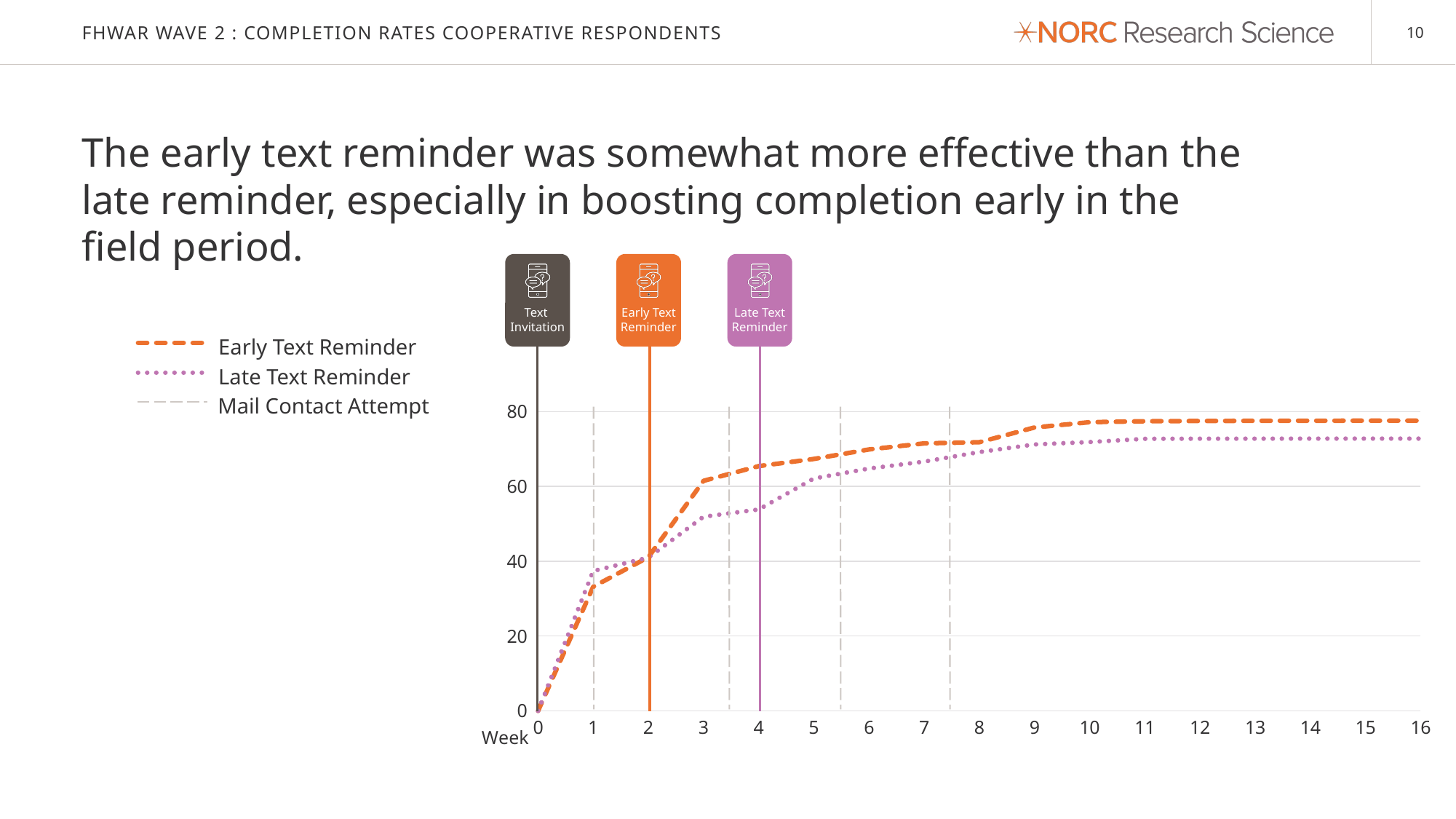
Which two data series are plotted as lines on the chart? Early Text Reminder and Late Text Reminder At week 16, which series has the higher completion rate, Early Text Reminder or Late Text Reminder? Early Text Reminder Do the completion rates rise or fall as the weeks increase? Rise How many week ticks are labelled on the x axis? 17 At week 1, which series has the higher completion rate, Early Text Reminder or Late Text Reminder? Late Text Reminder What colour is the Early Text Reminder line? Orange How many entries does the chart legend list? 3 Is the value for Early Text Reminder at week 4 greater or less than 60? greater Is the value for Late Text Reminder at week 1 greater or less than 40? less What kind of chart is shown on the slide? Line chart At week 3, which series has the higher completion rate, Early Text Reminder or Late Text Reminder? Early Text Reminder Is the value for Early Text Reminder at week 16 greater or less than 80? less